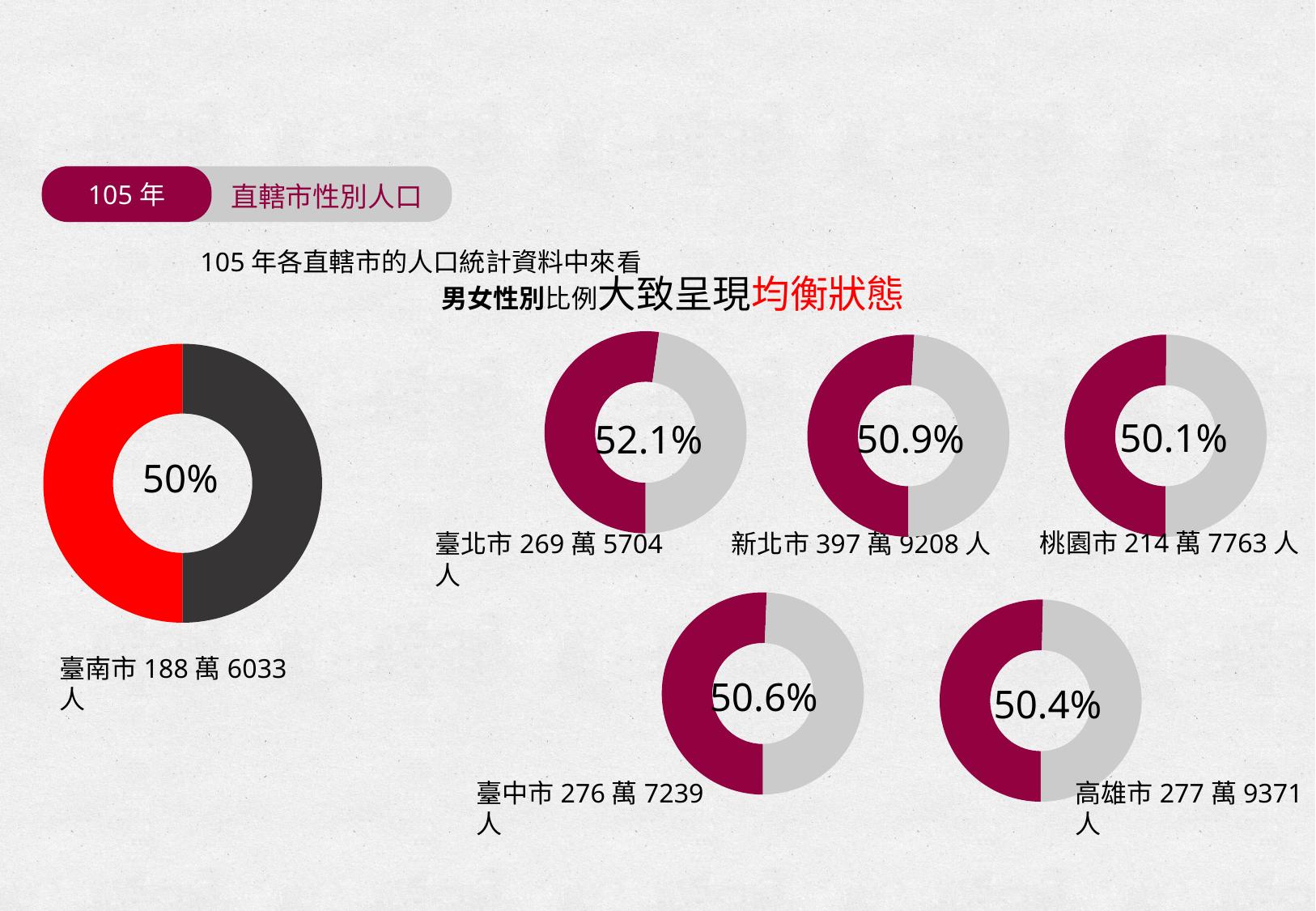
What percentage is shown in the donut chart for 高雄市? 50.4% What percentage is shown in the donut chart for 臺北市? 52.1% What percentage is shown in the large donut chart for 臺南市 on the left of the slide? 50% How many donut charts are shown on the slide? 6 What kind of chart is used to show the percentage for each city on this slide? Donut (pie) chart Which city's donut chart shows the lowest percentage? 臺南市 What percentage is shown in the donut chart for 新北市? 50.9% What percentage is shown in the donut chart for 桃園市? 50.1% What percentage is shown in the donut chart for 臺中市? 50.6% What is the difference between the percentage shown for 臺北市 and the percentage shown for 新北市? 1.2 percentage points Which city's donut chart shows the highest percentage? 臺北市 Which shows a larger percentage, the donut chart for 臺中市 or the donut chart for 高雄市? 臺中市